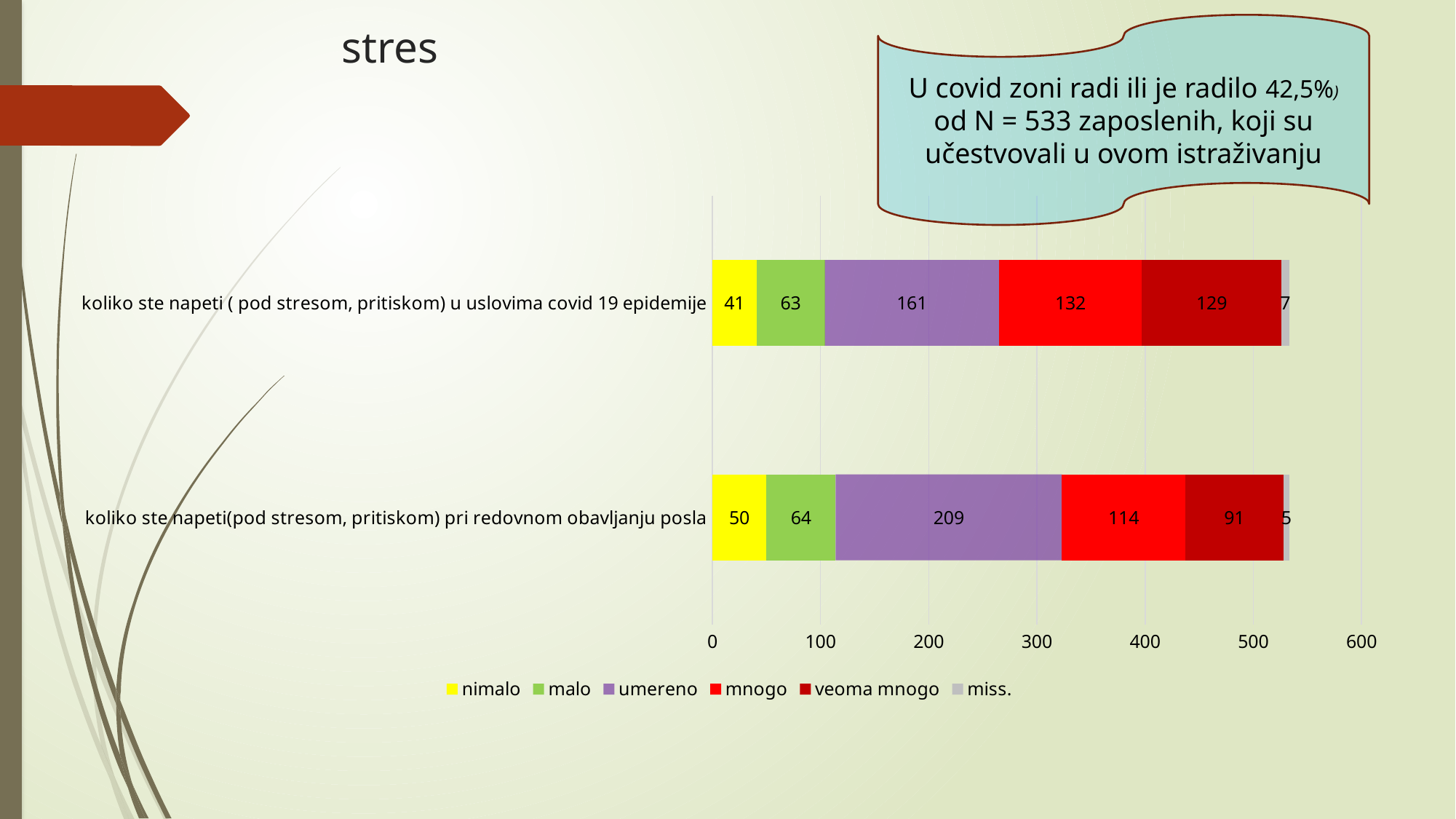
How many series does the legend list? 6 How many categories (bars) are plotted in the chart? 2 What kind of chart is shown on the slide? stacked bar chart What is the value of "veoma mnogo" for "koliko ste napeti ( pod stresom, pritiskom) u uslovima covid 19 epidemije"? 129 Which series has the lowest value in the bar for "koliko ste napeti ( pod stresom, pritiskom) u uslovima covid 19 epidemije"? miss. Which bar has the larger "veoma mnogo" value: the covid 19 epidemije bar or the redovnom obavljanju posla bar? koliko ste napeti ( pod stresom, pritiskom) u uslovima covid 19 epidemije What is the value of "nimalo" for "koliko ste napeti(pod stresom, pritiskom) pri redovnom obavljanju posla"? 50 What is the total of the stacked bar for "koliko ste napeti ( pod stresom, pritiskom) u uslovima covid 19 epidemije"? 533 Which series has the highest value in the bar for "koliko ste napeti(pod stresom, pritiskom) pri redovnom obavljanju posla"? umereno What is the value of "umereno" for "koliko ste napeti(pod stresom, pritiskom) pri redovnom obavljanju posla"? 209 What is the difference between the "mnogo" values of the two bars (132 and 114)? 18 What is the value of "umereno" for "koliko ste napeti ( pod stresom, pritiskom) u uslovima covid 19 epidemije"? 161